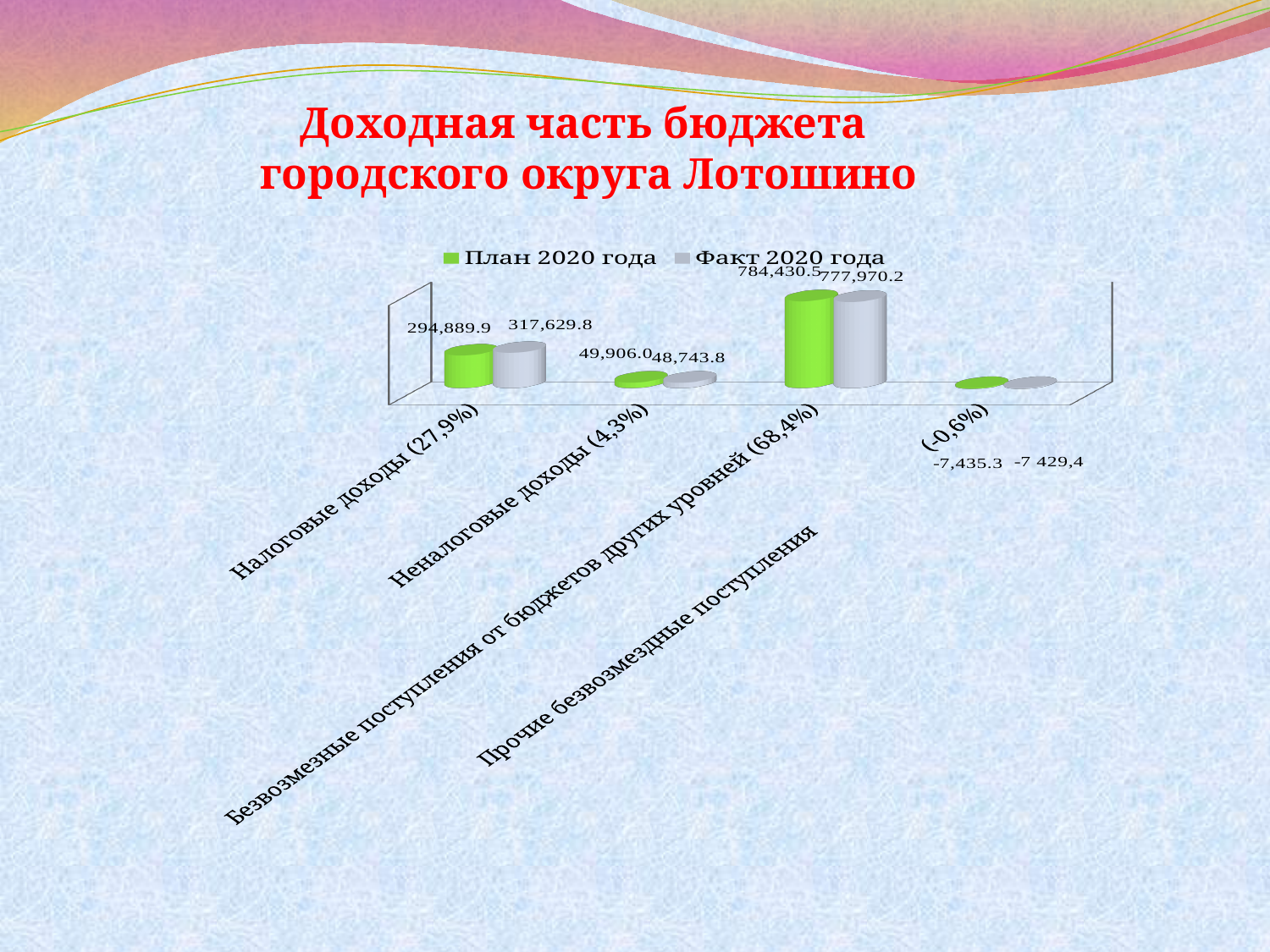
What is the value of Факт 2020 года for Неналоговые доходы? 48,743.8 What is the difference between Факт 2020 года and План 2020 года for Налоговые доходы? 22,739.9 What is the value of План 2020 года for Безвозмездные поступления от бюджетов других уровней? 784,430.5 How many categories are shown on the x axis of the chart? 4 For Безвозмездные поступления от бюджетов других уровней, which is larger: План 2020 года or Факт 2020 года? План 2020 года What is the value of План 2020 года for Прочие безвозмездные поступления? -7,435.3 What type of chart is shown on the slide? Bar chart What is the value of План 2020 года for Налоговые доходы? 294,889.9 What is the value of Факт 2020 года for Налоговые доходы? 317,629.8 How many series does the legend list? 2 Which category has the highest value for Факт 2020 года? Безвозмездные поступления от бюджетов других уровней Which category has the lowest value for План 2020 года? Прочие безвозмездные поступления